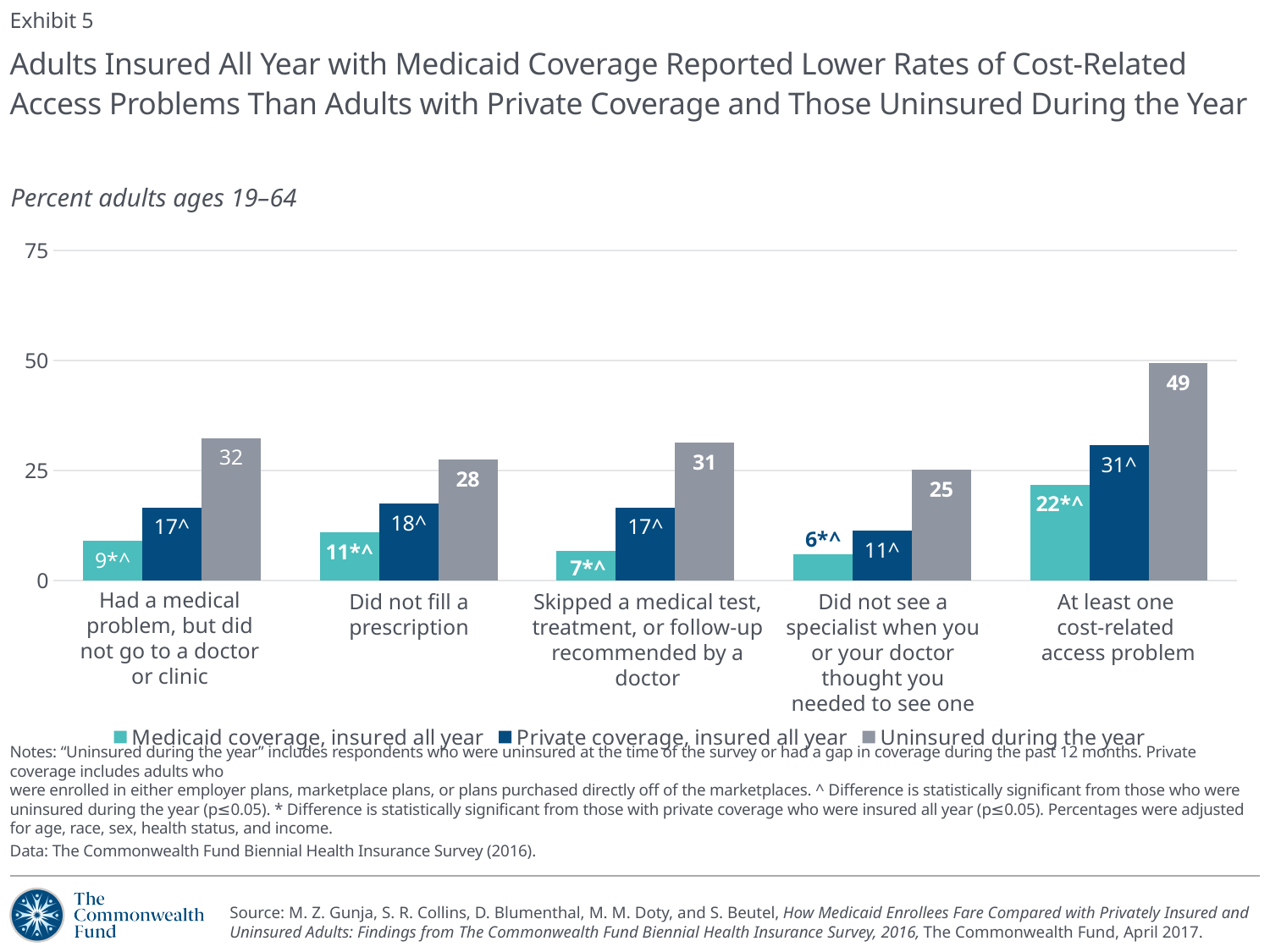
What is the value for 'Private coverage, insured all year' in the 'Did not see a specialist when you or your doctor thought you needed to see one' category? 11 Which category has the highest value for 'Uninsured during the year'? At least one cost-related access problem What is the value for 'Uninsured during the year' in the 'At least one cost-related access problem' category? 49 What is the value for 'Medicaid coverage, insured all year' in the 'Did not fill a prescription' category? 11 Which series is shown in the lightest (teal) colour in the legend? Medicaid coverage, insured all year In the 'Skipped a medical test, treatment, or follow-up recommended by a doctor' category, which is larger: the value for 'Private coverage, insured all year' or 'Medicaid coverage, insured all year'? Private coverage, insured all year What type of chart is shown on the slide? Bar chart How many series does the legend list? 3 What is the difference between the 'Uninsured during the year' and 'Medicaid coverage, insured all year' values in the 'At least one cost-related access problem' category? 27 Is the value for 'Uninsured during the year' in the 'Had a medical problem, but did not go to a doctor or clinic' category greater or less than 25? greater How many categories of cost-related access problems are shown on the x axis? 5 Which category has the lowest value for 'Medicaid coverage, insured all year'? Did not see a specialist when you or your doctor thought you needed to see one